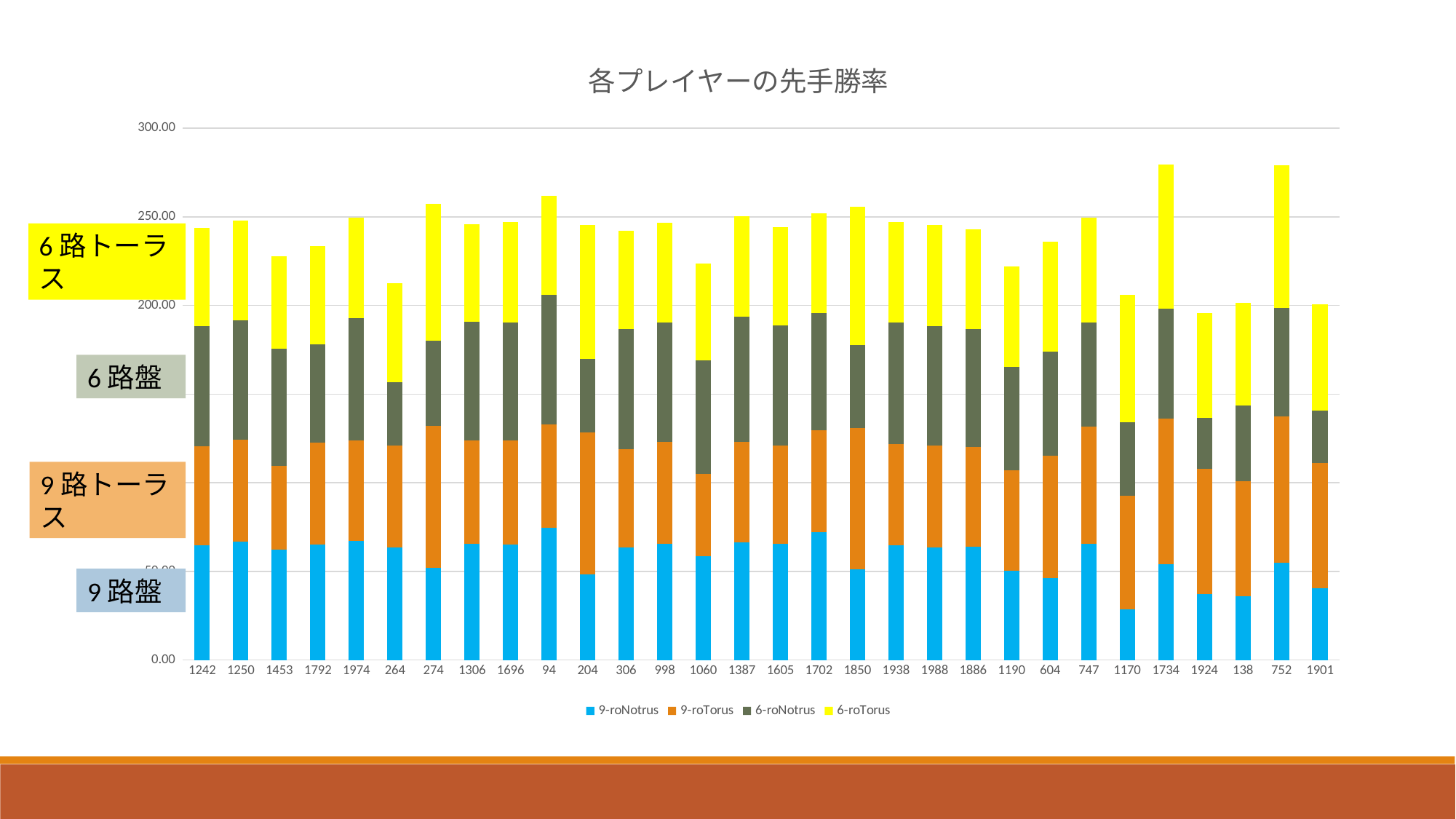
Which has the larger total stacked value, player 1734 or player 1170? 1734 Which has the larger total stacked value, player 94 or player 264? 94 Is the total stacked value for player 94 greater or less than 250? greater What kind of chart is shown on the slide? stacked bar chart Is the total stacked value for player 264 greater or less than 250? less How many player categories are shown along the x axis? 30 What is the title of the chart? 各プレイヤーの先手勝率 Which series is drawn in yellow? 6-roTorus Is the total stacked value for player 1734 greater or less than 250? greater How many series does the legend list? 4